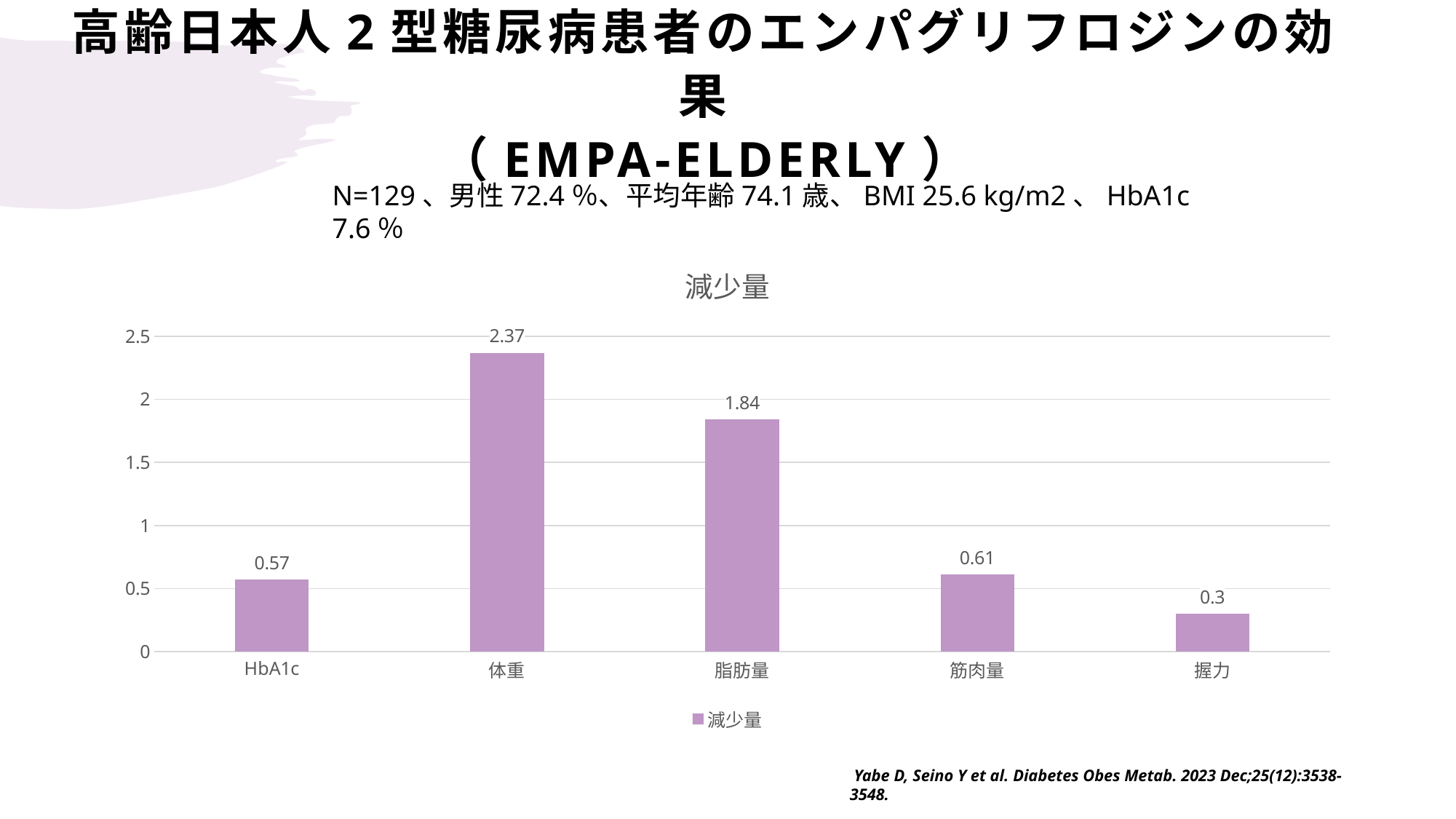
Which category has the lowest value in the 減少量 chart? 握力 What is the value for 握力 in the 減少量 chart? 0.3 Is the value for 脂肪量 greater or less than 1.5? greater What is the title of the chart? 減少量 How many categories are shown on the x axis of the chart? 5 What is the value for 脂肪量 in the 減少量 chart? 1.84 What is the difference between the values for 体重 and 脂肪量? 0.53 What kind of chart is shown on the slide? bar chart Which category has the highest value in the 減少量 chart? 体重 What is the value for 体重 in the 減少量 chart? 2.37 What is the value for HbA1c in the 減少量 chart? 0.57 Which is larger, the value for 筋肉量 or the value for HbA1c? 筋肉量